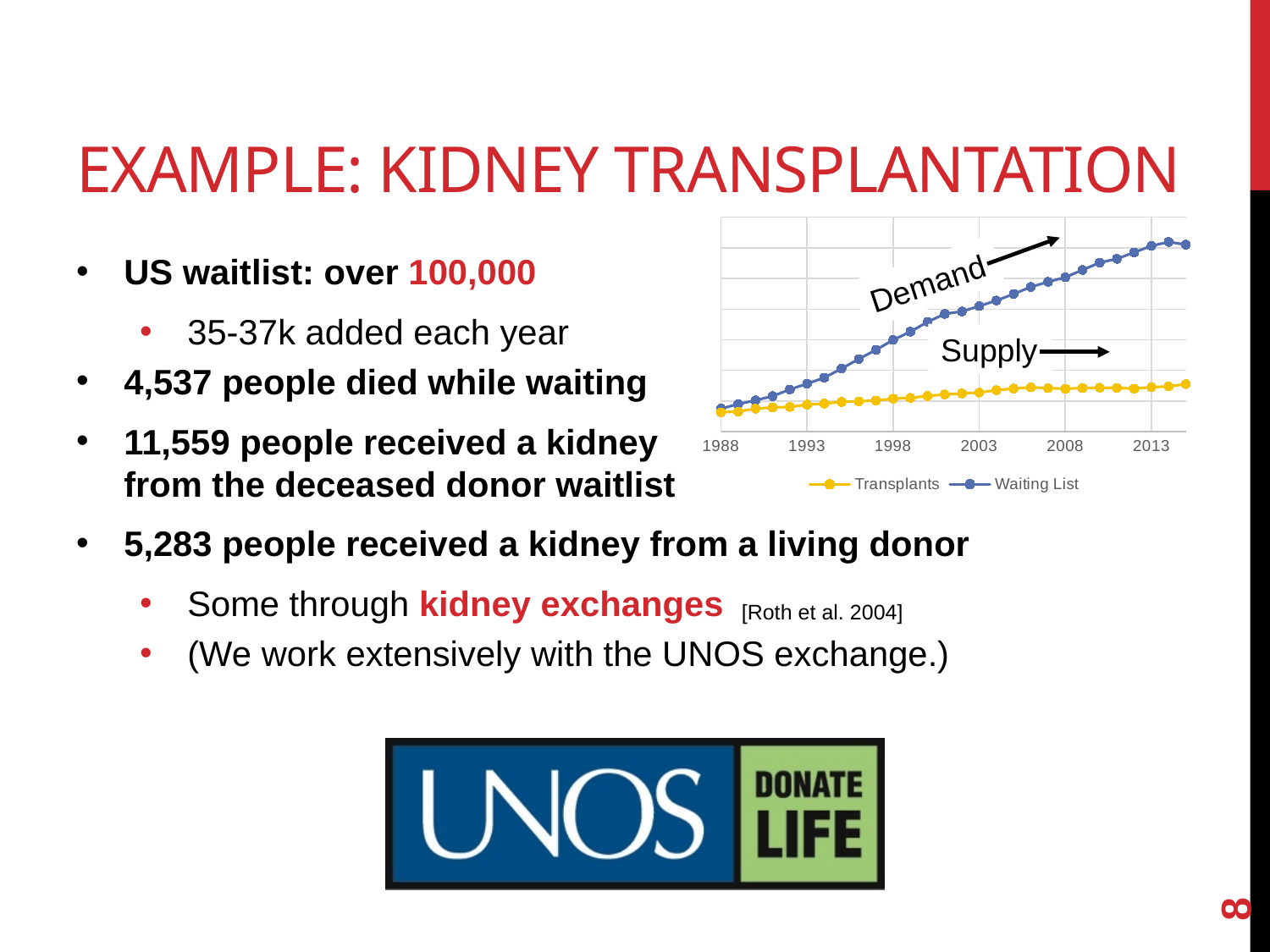
How many year labels are shown on the chart's x axis? 6 Does the Waiting List series rise or fall from 1988 to 2013? rise Which colour is used for the Waiting List series in the chart? blue Which series shows the steeper increase over the period, Transplants or Waiting List? Waiting List Does the Transplants series rise or fall over the years shown? rise What is the first year labelled on the chart's x axis? 1988 What kind of chart is shown on the slide? line chart Which series is higher in 2013, Transplants or Waiting List? Waiting List How many series does the chart's legend list? 2 What is the last year labelled on the chart's x axis? 2013 What are the two series named in the chart's legend? Transplants and Waiting List Which series in the chart is annotated with the word 'Supply'? Transplants